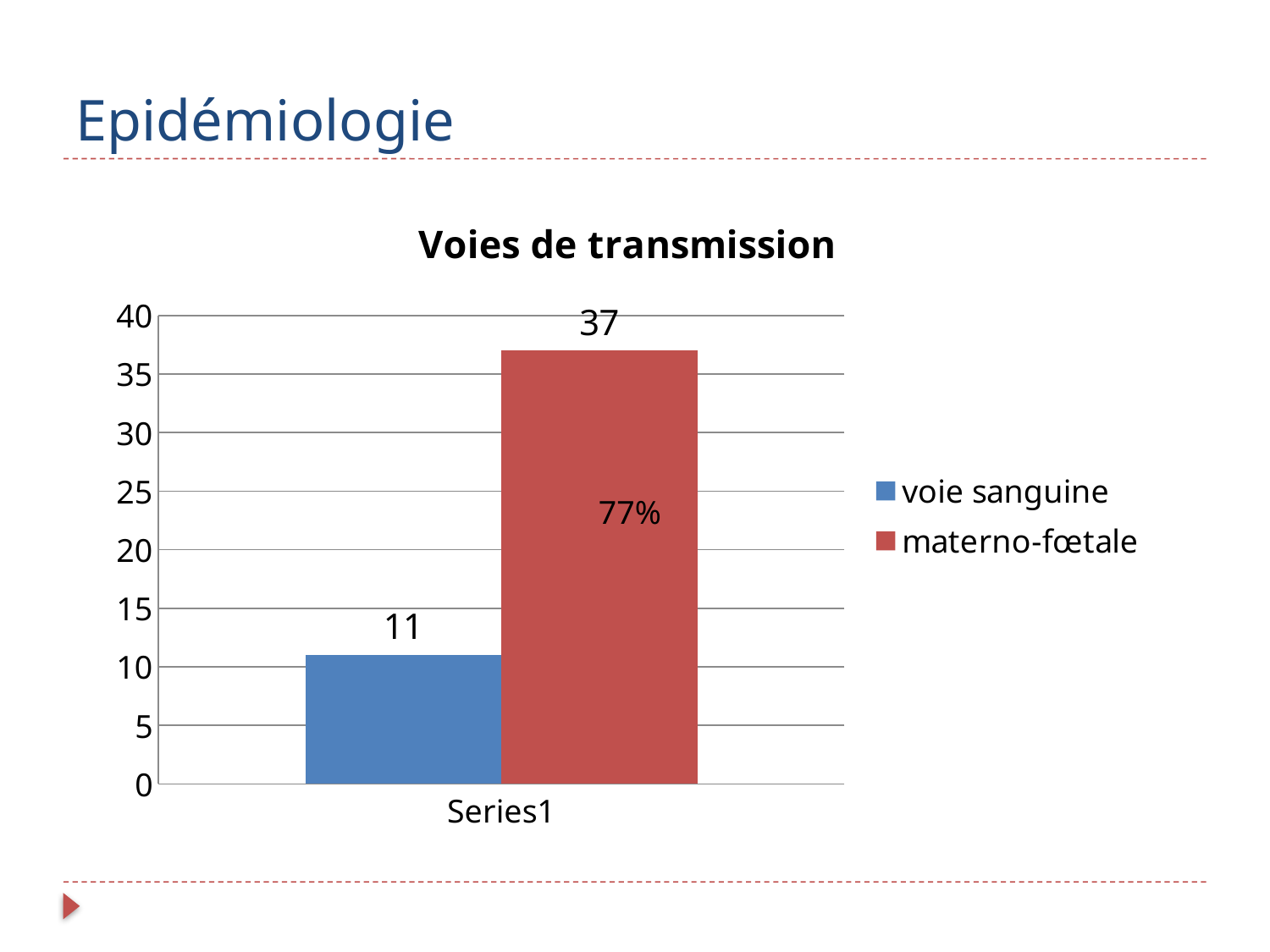
Is the value for voie sanguine greater or less than 15? less What is the title of the chart? Voies de transmission Which series has the lowest value? voie sanguine What is the value for materno-fœtale? 37 Is the value for materno-fœtale greater or less than 35? greater What kind of chart is shown? bar chart What percentage label is printed on the materno-fœtale bar? 77% What is the value for voie sanguine? 11 How many series does the legend list? 2 Which is larger, the value for voie sanguine or the value for materno-fœtale? materno-fœtale What is the difference between the values for materno-fœtale and voie sanguine? 26 Which series has the highest value? materno-fœtale